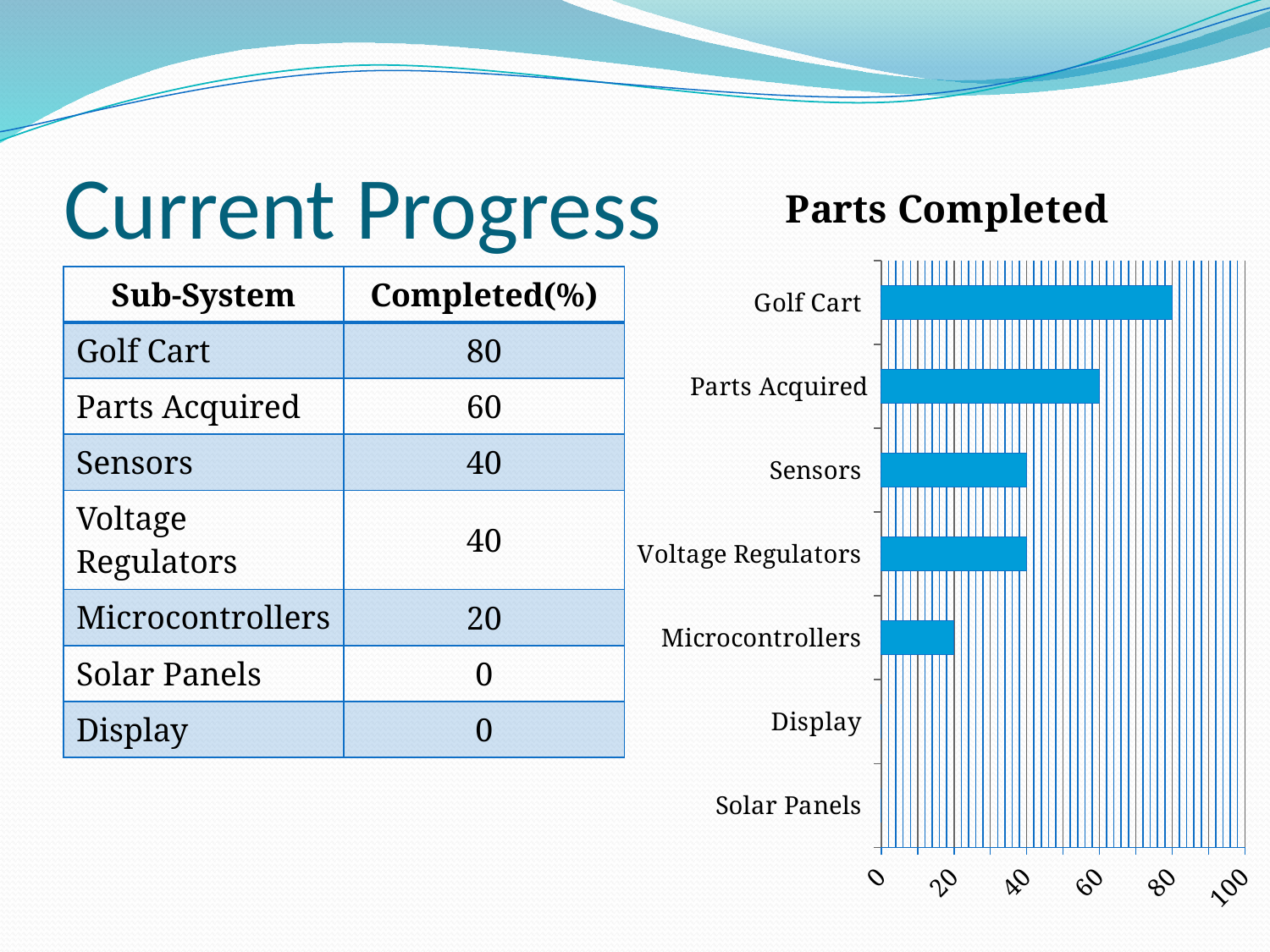
Is the value for Parts Acquired greater or less than 40? greater What is the value for Sensors in the Parts Completed chart? 40 What is the value for Parts Acquired in the Parts Completed chart? 60 What is the value for Microcontrollers in the Parts Completed chart? 20 What kind of chart is shown on the slide? bar chart How many categories are plotted in the Parts Completed chart? 7 Which is larger, the value for Sensors or the value for Microcontrollers? Sensors What is the value for Golf Cart in the Parts Completed chart? 80 What is the difference between the values for Golf Cart and Microcontrollers? 60 Which category has the highest value in the Parts Completed chart? Golf Cart What is the title of the chart? Parts Completed What is the difference between the values for Golf Cart and Parts Acquired? 20